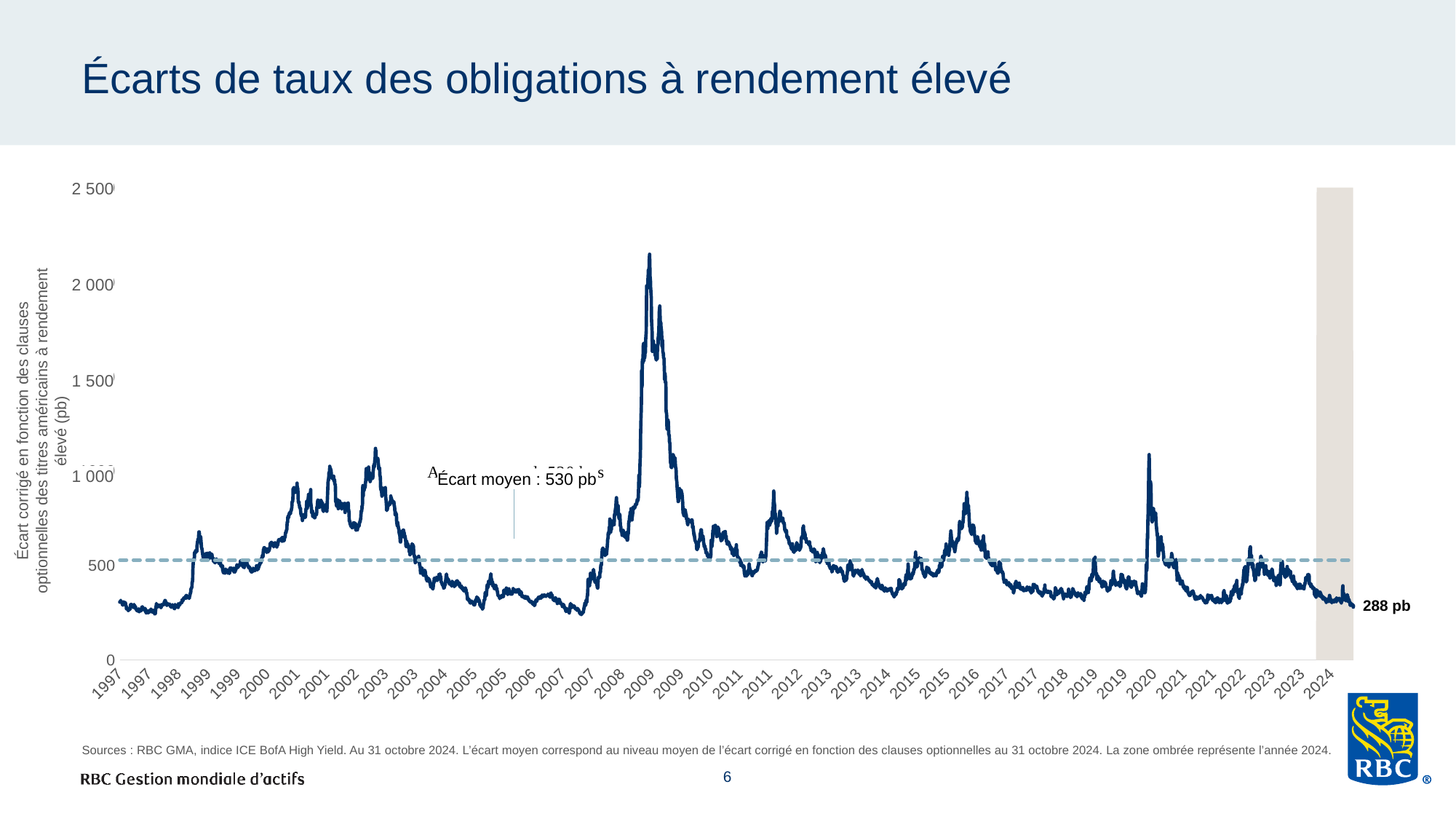
What is the average spread (écart moyen) indicated by the dashed line? 530 pb What is the most recent value of the high-yield spread labelled at the right end of the line? 288 pb What is the title of the slide? Écarts de taux des obligations à rendement élevé What kind of chart is shown on the slide? line chart Is the peak value of the spread around 2016 greater or less than 1 000? less Does the spread rise or fall between its 2020 peak and the end of 2024? fall By how much is the average spread of 530 pb higher than the latest value of 288 pb? 242 pb Is the spread at the start of the chart in 1997 greater or less than 500? less Is the peak value of the spread around 2009 greater or less than 2 000? greater Is the latest value of 288 pb greater or less than the average spread of 530 pb? less In which year does the spread reach its highest level on the chart? 2009 What is the highest tick value shown on the y axis? 2 500